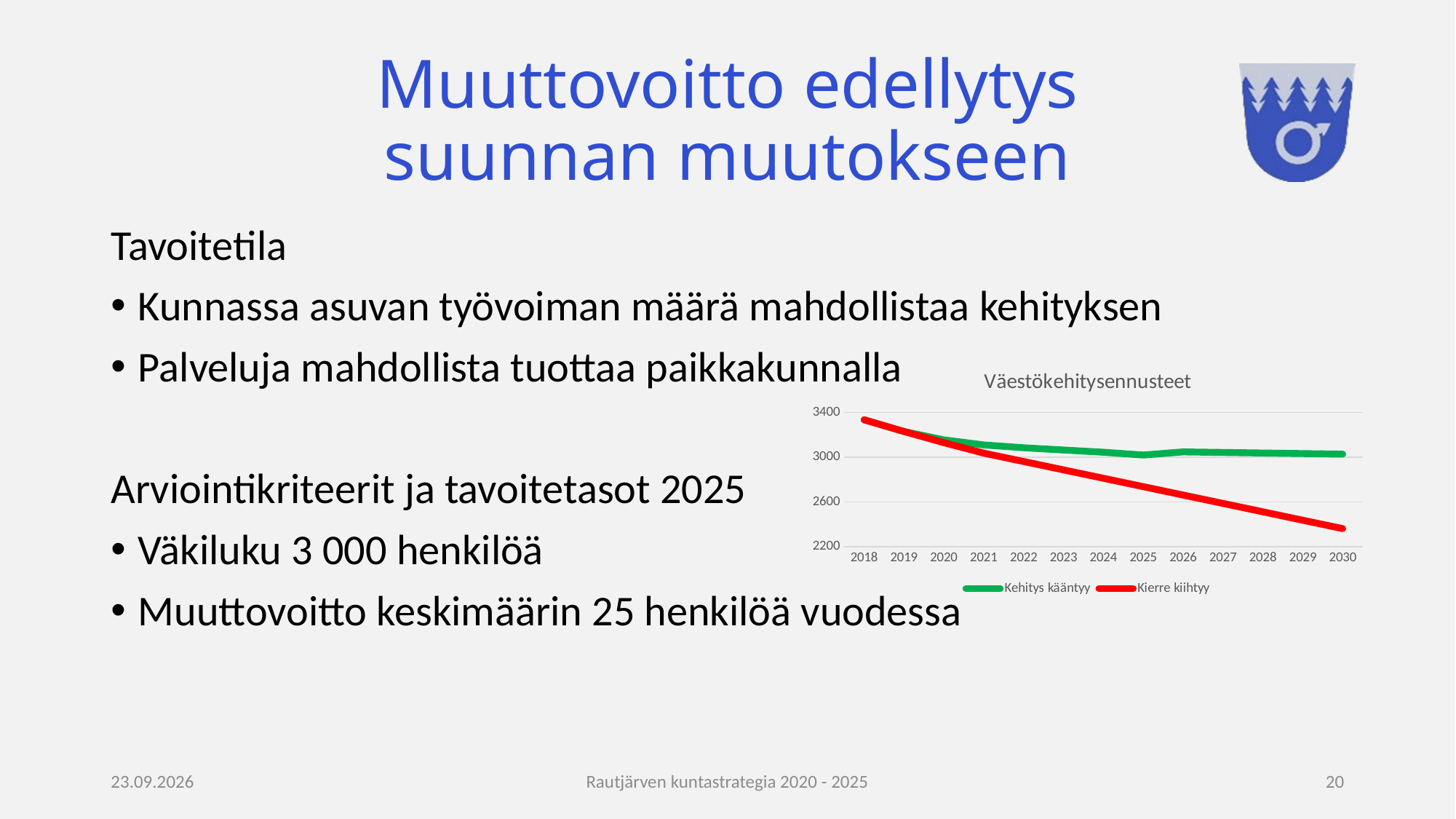
Is the value of the Kehitys kääntyy series in 2030 greater or less than 2600? greater How many series does the chart legend list? 2 Which series ends at the lowest value in 2030? Kierre kiihtyy What is the title of the chart? Väestökehitysennusteet Is the value of the Kierre kiihtyy series in 2030 greater or less than 2600? less What kind of chart is shown on the slide? Line chart Is the value of the Kierre kiihtyy series in 2018 greater or less than 3000? greater In 2030, which series has the higher value, Kehitys kääntyy or Kierre kiihtyy? Kehitys kääntyy Does the Kierre kiihtyy series rise or fall from 2018 to 2030? Fall How many years are shown on the x axis of the chart? 13 Which series is drawn in red? Kierre kiihtyy